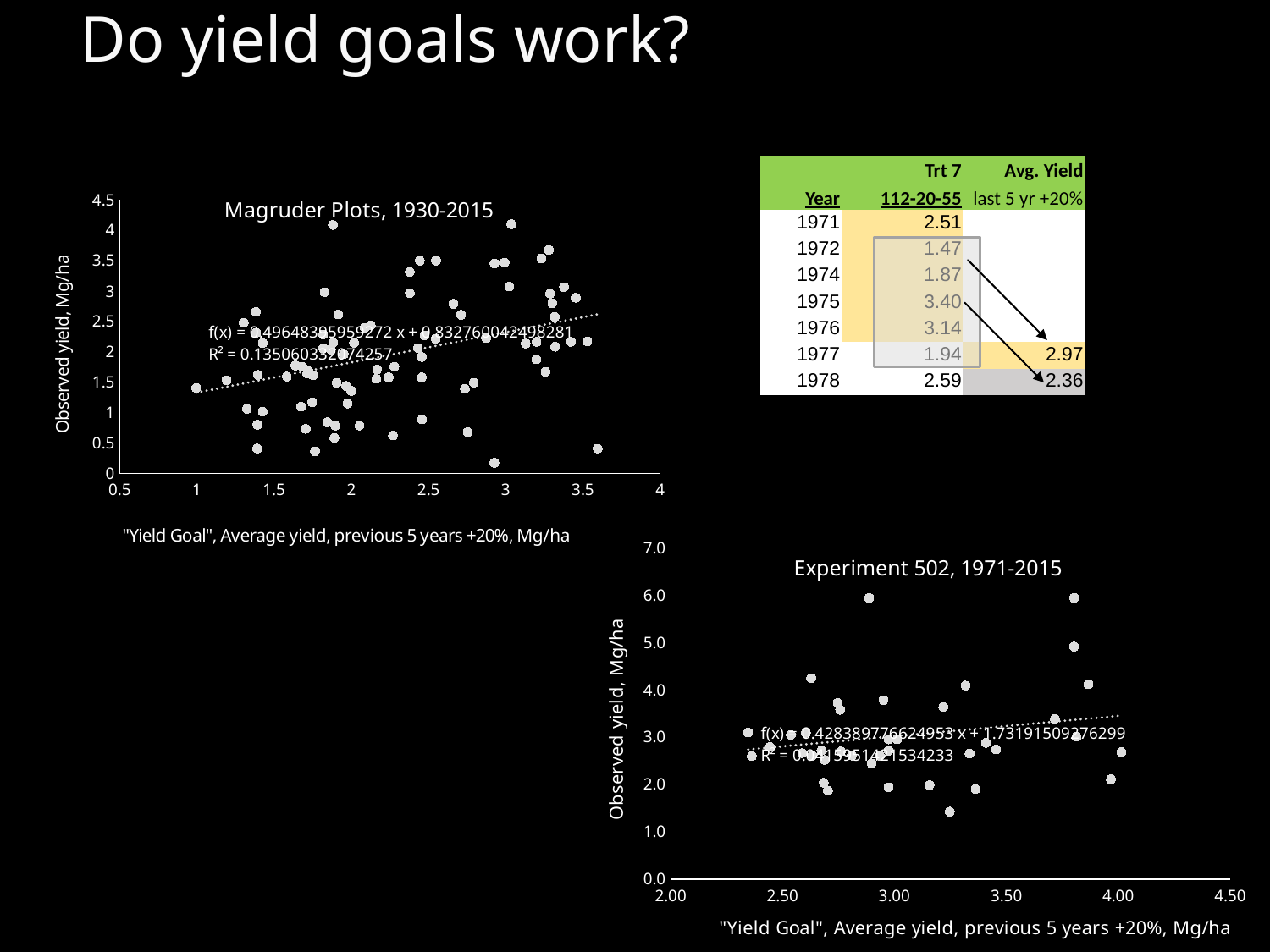
How many charts are shown on the slide? 2 In the "Magruder Plots, 1930-2015" chart, does the dotted trendline rise or fall as the yield goal increases along the x axis? rises What kind of chart is the "Magruder Plots, 1930-2015" chart? scatter chart What is the x-axis label of the "Experiment 502, 1971-2015" chart? "Yield Goal", Average yield, previous 5 years +20%, Mg/ha What kind of chart is the "Experiment 502, 1971-2015" chart? scatter chart What is the y-axis label of the "Magruder Plots, 1930-2015" chart? Observed yield, Mg/ha What R² value is printed on the "Magruder Plots, 1930-2015" chart? 0.135060352074257 In the "Experiment 502, 1971-2015" chart, does the dotted trendline rise or fall along the x axis? rises